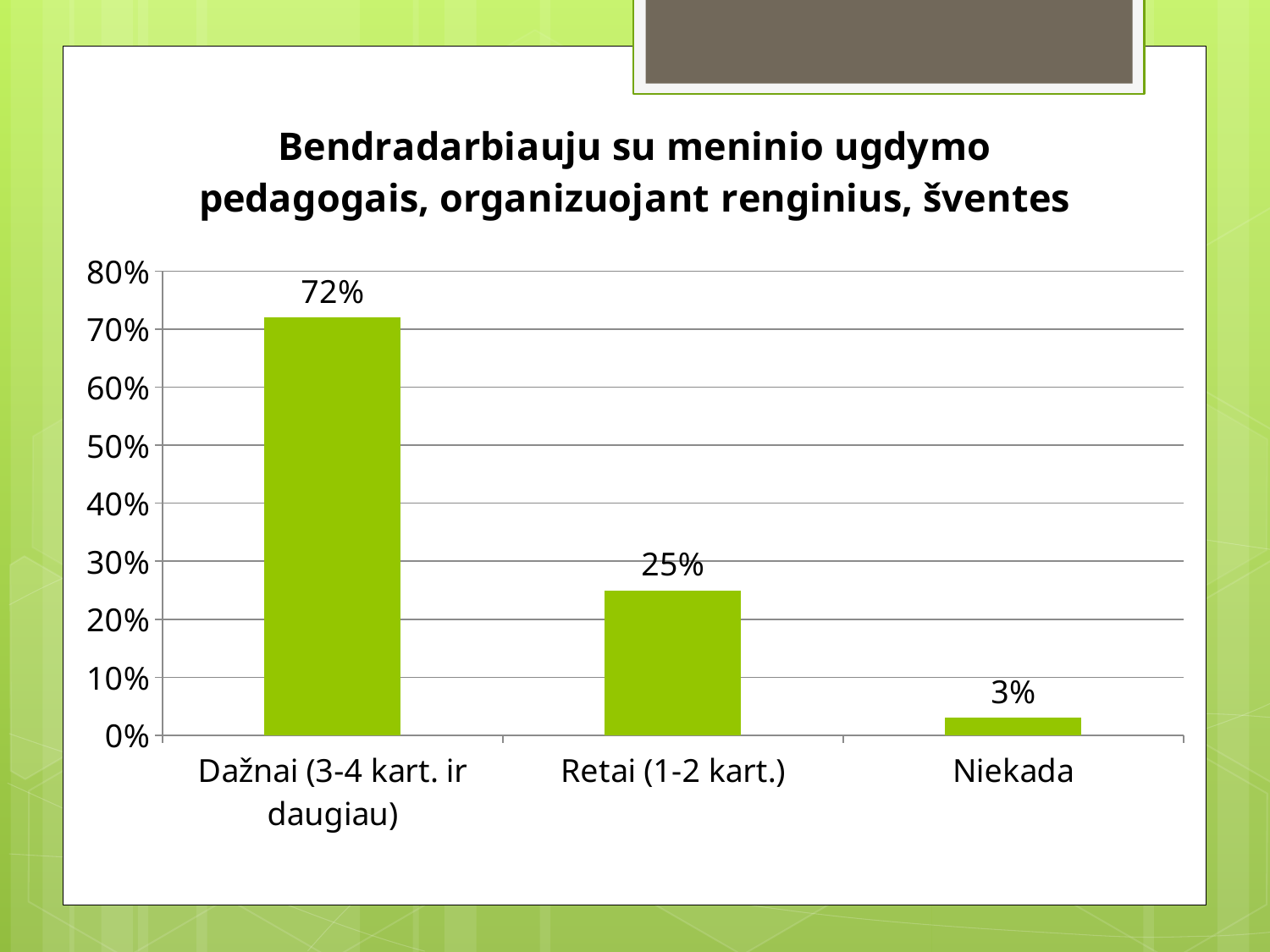
What is the difference between the values for Retai (1-2 kart.) and Niekada? 22% Which category has the lowest value? Niekada What is the difference between the values for Dažnai (3-4 kart. ir daugiau) and Retai (1-2 kart.)? 47% Is the value for Retai (1-2 kart.) greater or less than 30%? less Which category has the highest value? Dažnai (3-4 kart. ir daugiau) Which is larger, the value for Retai (1-2 kart.) or the value for Niekada? Retai (1-2 kart.) What kind of chart is shown on the slide? bar chart Do the values rise or fall from left to right along the x axis? fall What is the value for Retai (1-2 kart.)? 25% What is the value for Dažnai (3-4 kart. ir daugiau)? 72% How many categories are shown on the x axis? 3 What is the value for Niekada? 3%